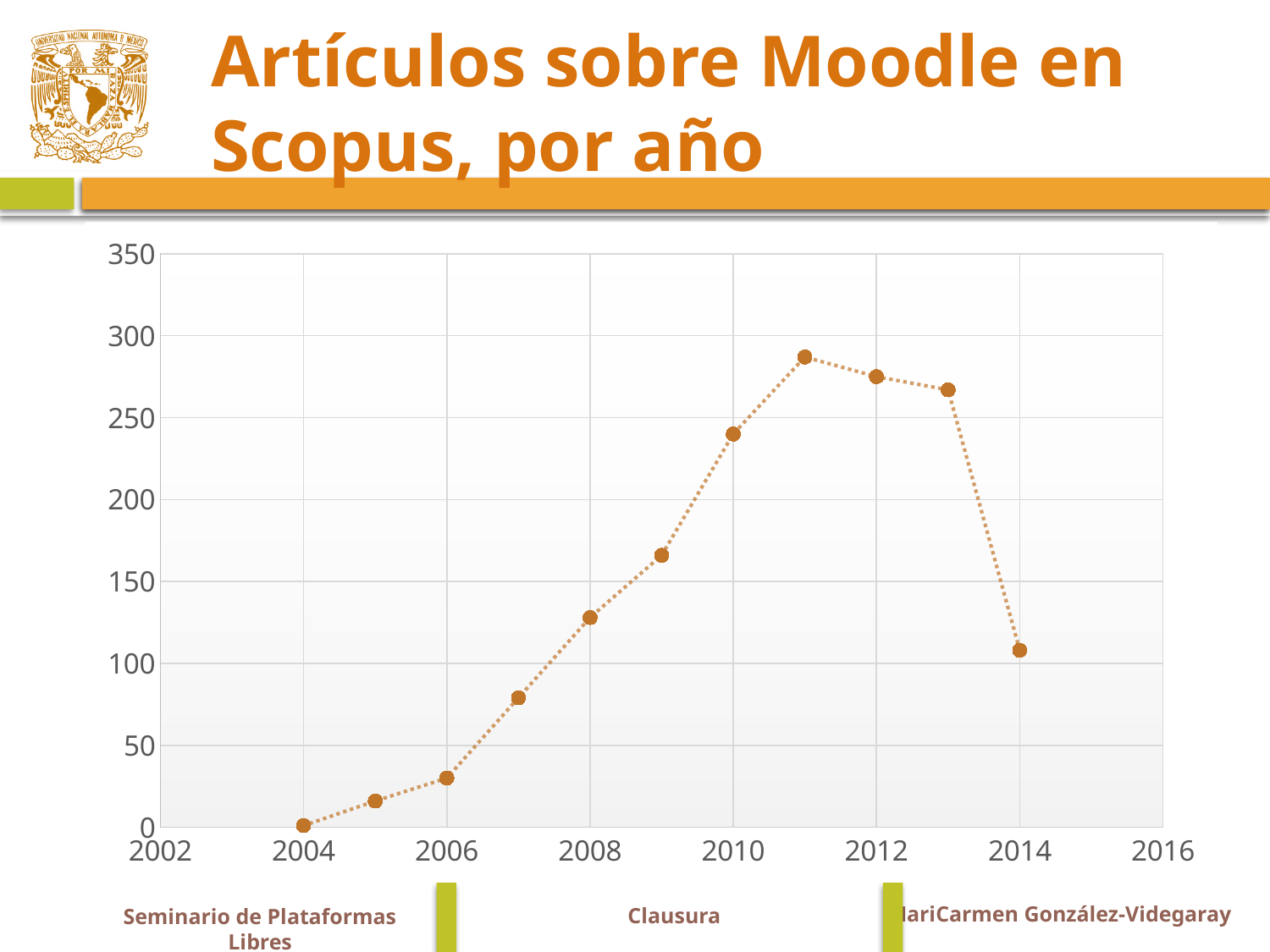
Is the value for 2008 greater or less than 100? greater Is the value for 2010 greater or less than 200? greater Which year has a higher value, 2008 or 2014? 2008 Is the value for 2013 greater or less than 250? greater What kind of chart is shown on the slide? Line chart Do the values rise or fall from 2004 to 2011? rise Which year has the highest number of articles? 2011 What is the title of the chart? Artículos sobre Moodle en Scopus, por año Which year has the lowest number of articles? 2004 How many data points are plotted on the chart? 11